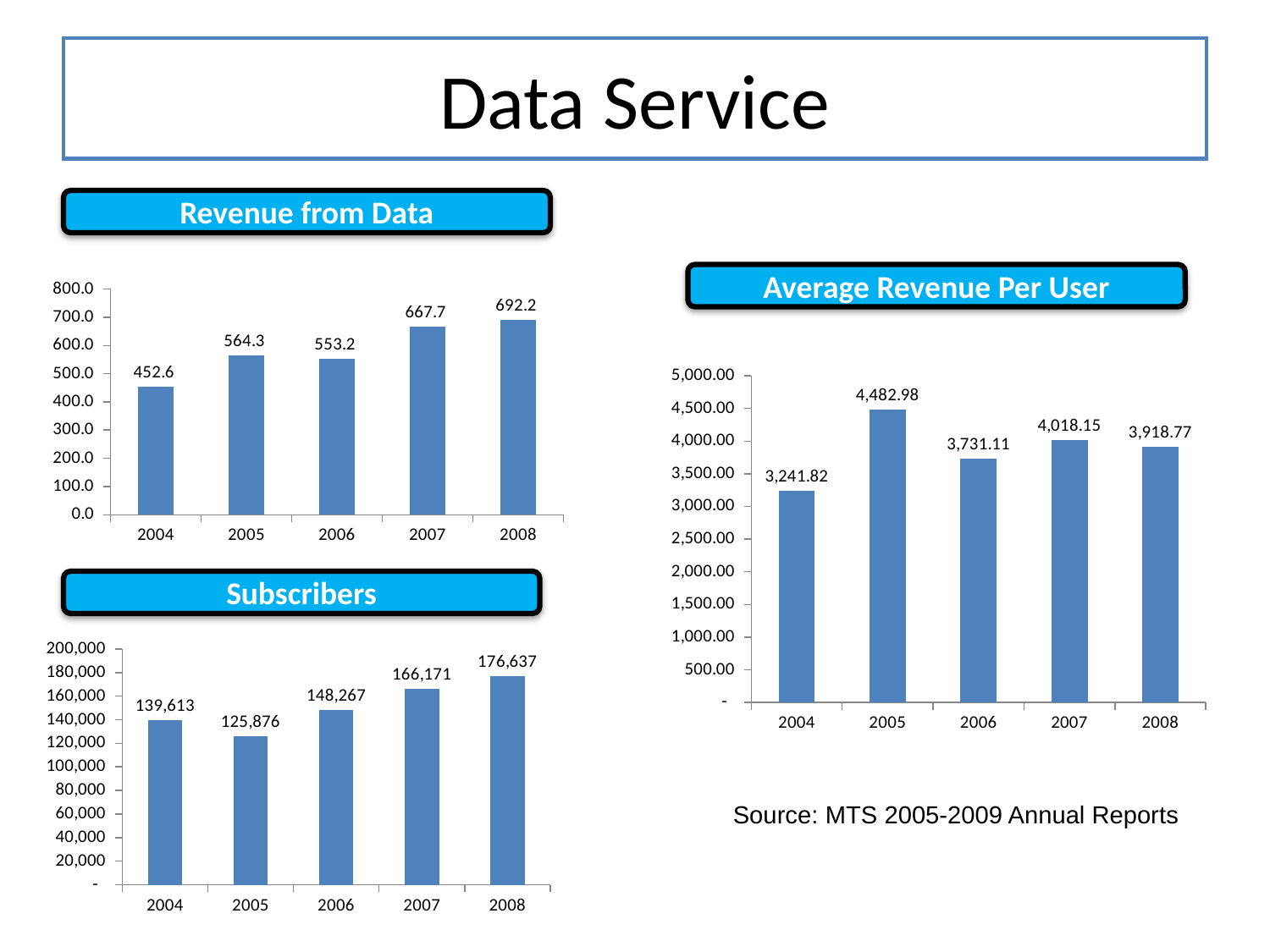
In the Average Revenue Per User chart, which year has the highest value? 2005 In the Revenue from Data chart, what is the value for 2006? 553.2 How many years are shown on the x axis of the Subscribers chart? 5 In the Subscribers chart, which year has the lowest value? 2005 What kind of chart is the Revenue from Data chart? Bar chart In the Average Revenue Per User chart, which is larger, the value for 2006 or the value for 2008? 2008 In the Revenue from Data chart, what is the difference between the 2008 and 2004 values? 239.6 In the Revenue from Data chart, which year has the highest value? 2008 In the Subscribers chart, what is the value for 2005? 125,876 In the Subscribers chart, is the value for 2007 greater or less than 160,000? greater In the Average Revenue Per User chart, what is the difference between the 2005 and 2004 values? 1,241.16 In the Average Revenue Per User chart, what is the value for 2007? 4,018.15